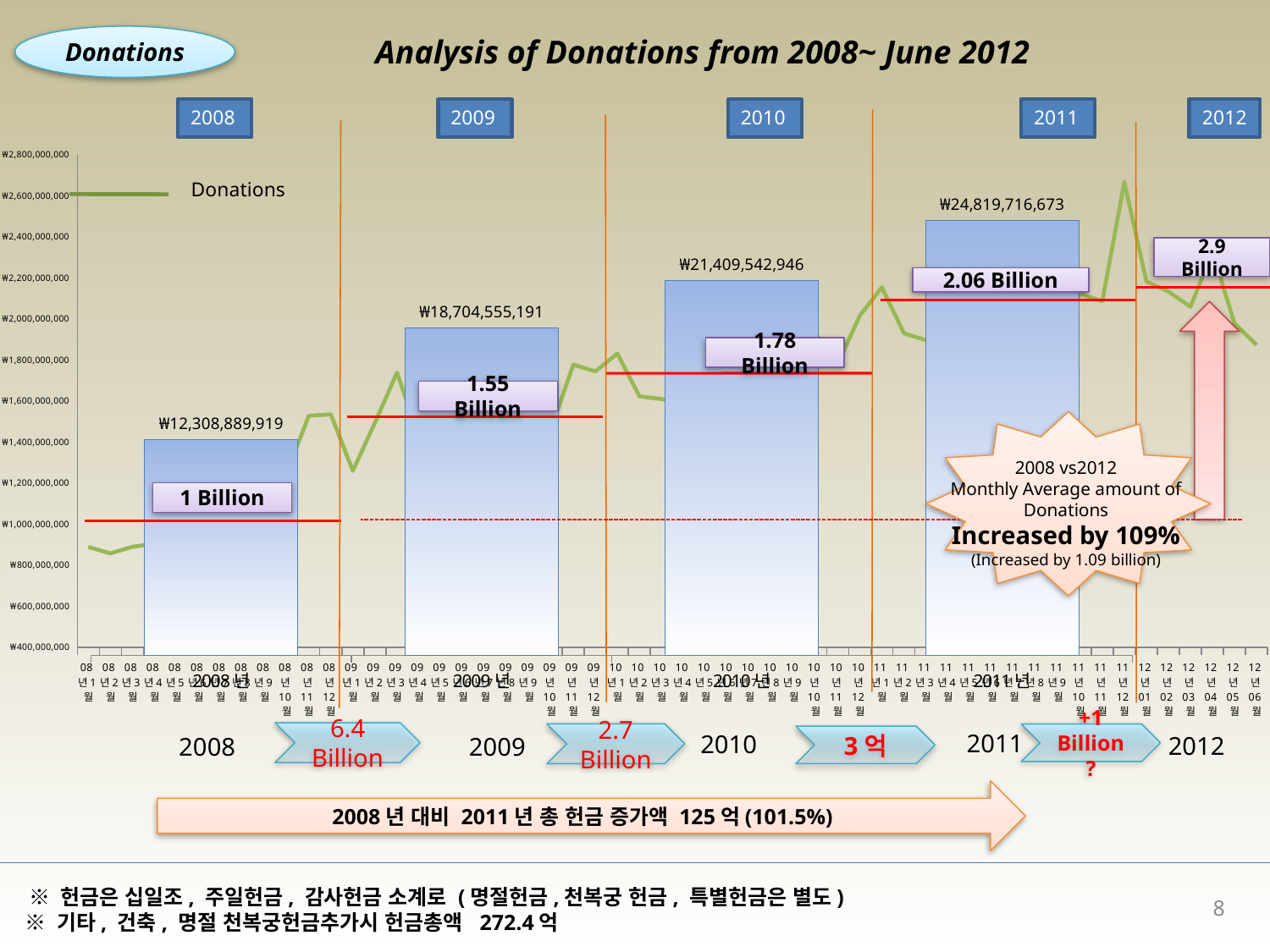
Which year has the lowest annual donation total on the chart? 2008 Do the annual donation totals rise or fall from 2008 to 2011? rise What is the title of the chart? Analysis of Donations from 2008~ June 2012 What monthly average donation amount is labelled for 2009? 1.55 Billion What is the difference between the 2011 and 2008 annual donation totals? ₩12,510,826,754 Which year has the highest annual donation total on the chart? 2011 What is the total donation amount shown for 2009? ₩18,704,555,191 What is the total donation amount shown for 2008? ₩12,308,889,919 What is the total donation amount shown for 2010? ₩21,409,542,946 Which year has the larger annual donation total, 2009 or 2010? 2010 What is the total donation amount shown for 2011? ₩24,819,716,673 What monthly average donation amount is labelled for 2012? 2.9 Billion